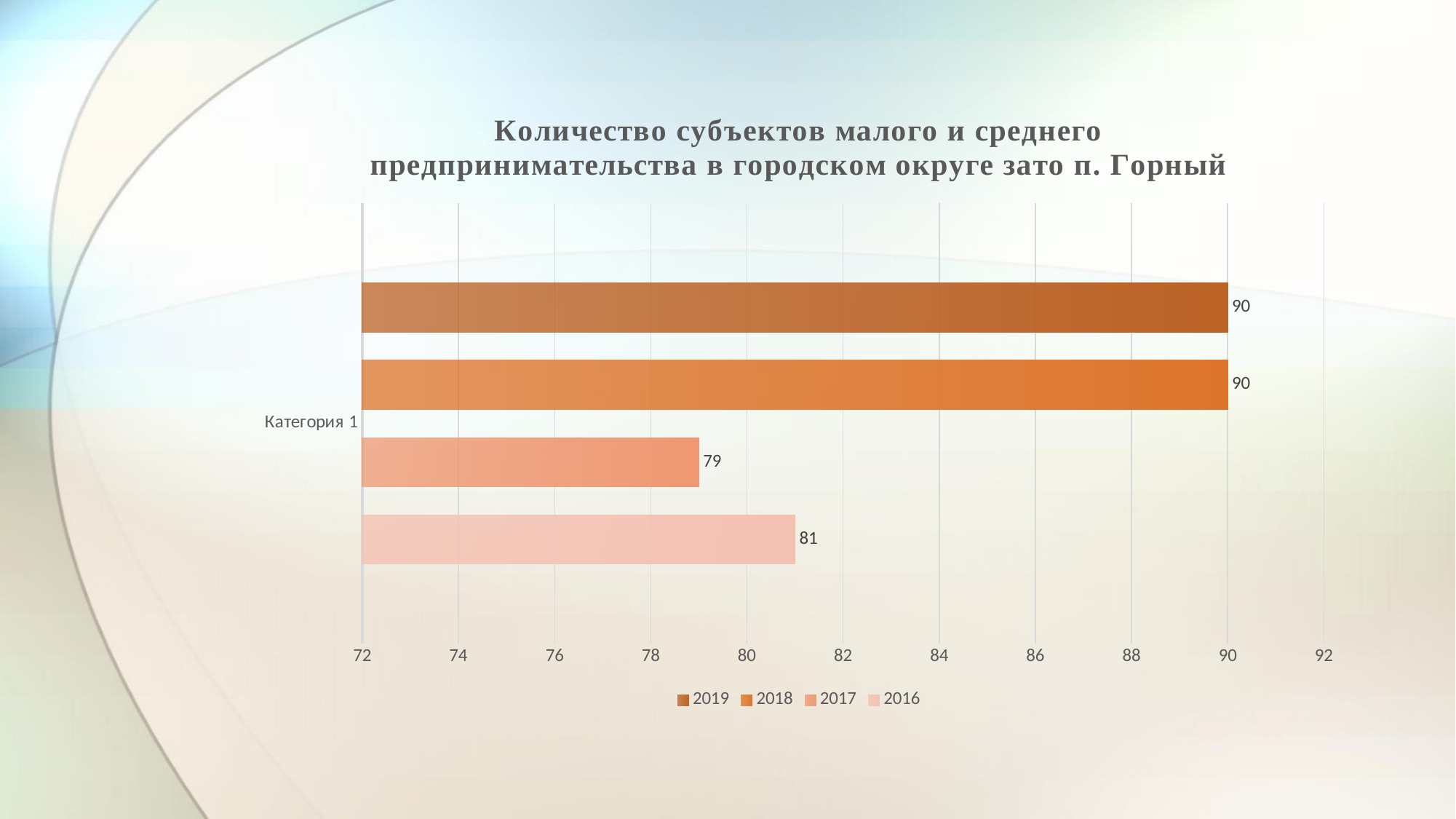
What is the value for 2018? 90 What is the value for 2016? 81 What is the category label shown on the vertical axis? Категория 1 What kind of chart is shown on the slide? Bar chart What is the difference between the values for 2019 and 2017? 11 Which is larger, the value for 2016 or the value for 2017? 2016 What is the value for 2019? 90 What is the difference between the values for 2016 and 2017? 2 What is the value for 2017? 79 How many series does the legend list? 4 Which year has the lowest value? 2017 Is the value for 2016 greater or less than 80? greater